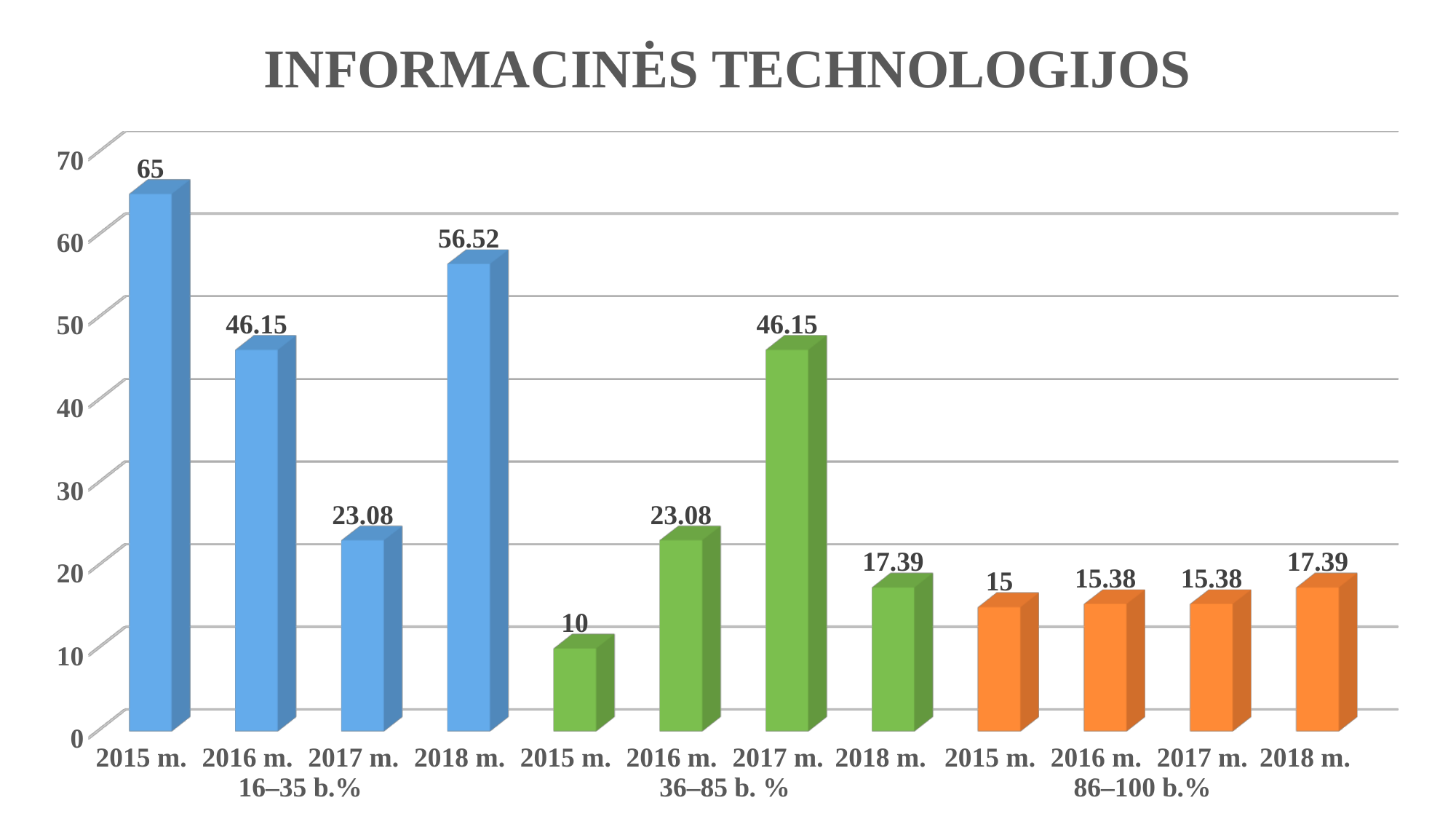
What is the value for 2018 m. in the 36–85 b. % group? 17.39 What is the value for 2015 m. in the 16–35 b.% group? 65 Is the value for 2018 m. in the 16–35 b.% group greater or less than 50? greater Which year has the lowest value in the 16–35 b.% group? 2017 m. What kind of chart is shown on the slide? bar chart What is the title of the chart? INFORMACINĖS TECHNOLOGIJOS What is the value for 2016 m. in the 86–100 b.% group? 15.38 Which is larger: the 2016 m. value in the 16–35 b.% group or the 2016 m. value in the 36–85 b. % group? 2016 m. in the 16–35 b.% group How many bars are plotted on the chart? 12 Which year has the highest value in the 36–85 b. % group? 2017 m. What colour are the bars for the 86–100 b.% group? orange What is the difference between the 2015 m. and 2018 m. values in the 16–35 b.% group? 8.48